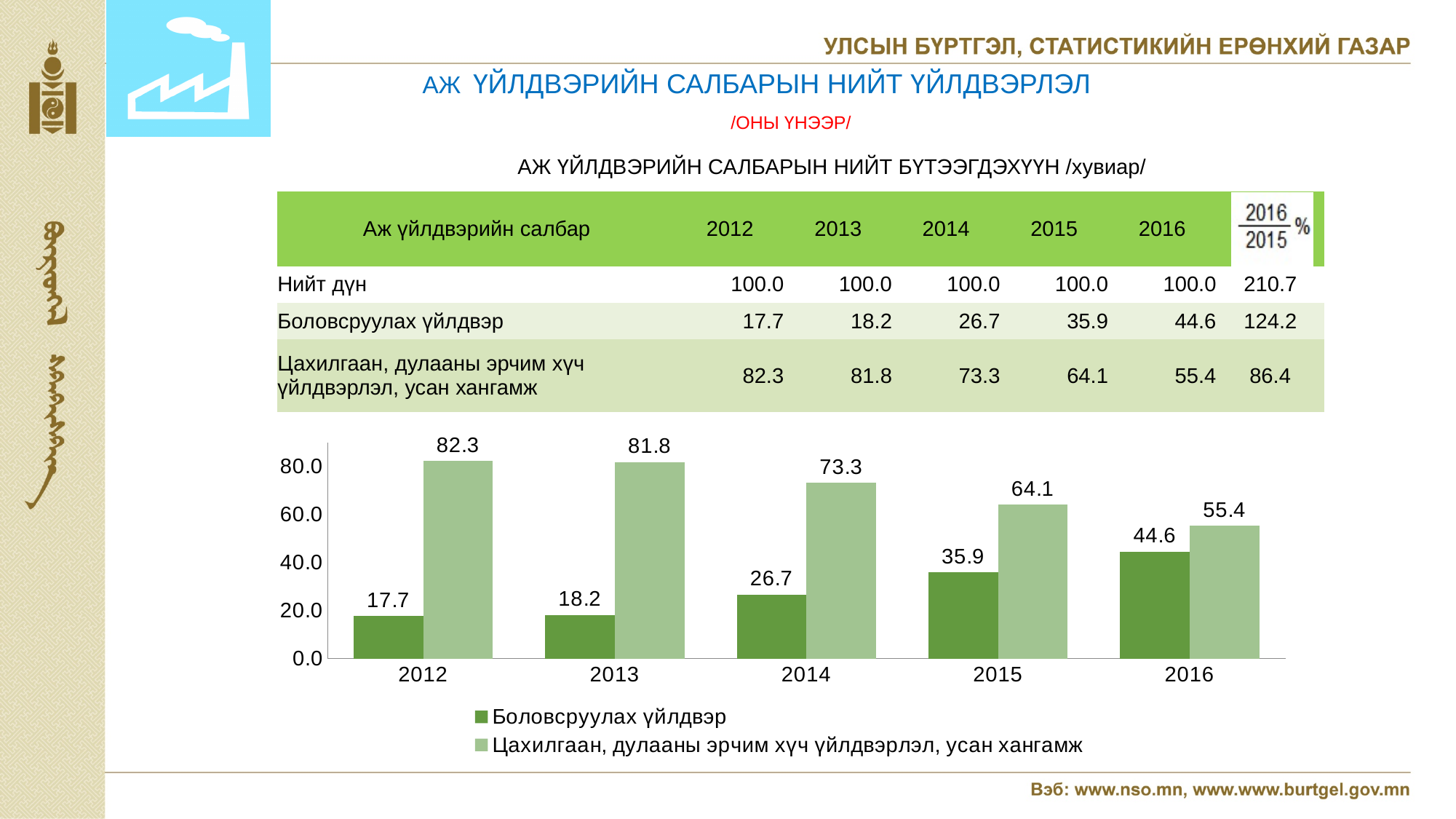
Does the value for Боловсруулах үйлдвэр rise or fall from 2012 to 2016? rise What is the difference between the two series' values in 2015? 28.2 What type of chart is shown on the slide? bar chart In which year is the value for Боловсруулах үйлдвэр highest? 2016 What is the value for Боловсруулах үйлдвэр in 2014? 26.7 How many years are shown on the x axis of the chart? 5 What is the difference between the Боловсруулах үйлдвэр values in 2016 and 2012? 26.9 Which series has the larger value in 2013? Цахилгаан, дулааны эрчим хүч үйлдвэрлэл, усан хангамж What is the value for Цахилгаан, дулааны эрчим хүч үйлдвэрлэл, усан хангамж in 2016? 55.4 How many series does the chart legend list? 2 In which year is the value for Цахилгаан, дулааны эрчим хүч үйлдвэрлэл, усан хангамж lowest? 2016 What is the value for Боловсруулах үйлдвэр in 2012? 17.7